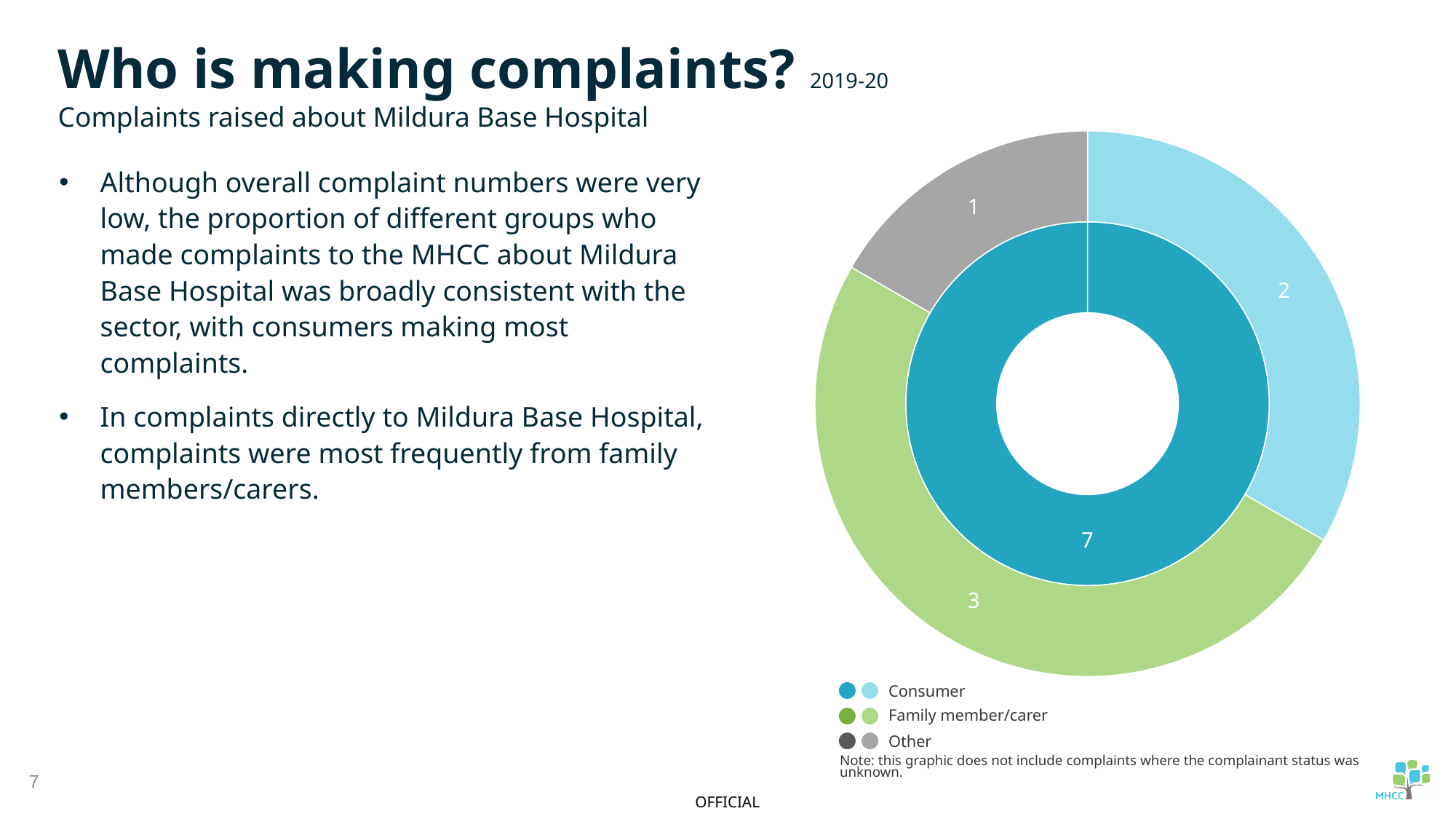
In the outer ring, is the value for Consumer larger or smaller than the value for Other? Larger In the outer ring of the doughnut chart, what is the value for Other? 1 What value is shown in the inner ring of the doughnut chart? 7 Which category has the largest value in the outer ring of the doughnut chart? Family member/carer In the outer ring of the doughnut chart, what is the value for Family member/carer? 3 Which category has the smallest value in the outer ring of the doughnut chart? Other In the outer ring, what is the difference between the Family member/carer value and the Consumer value? 1 What is the total of the values shown in the outer ring of the doughnut chart? 6 What type of chart is shown on the slide? Doughnut chart How many entries does the chart legend list? 3 Which legend entry is shown in green on the chart? Family member/carer In the outer ring of the doughnut chart, what is the value for Consumer? 2